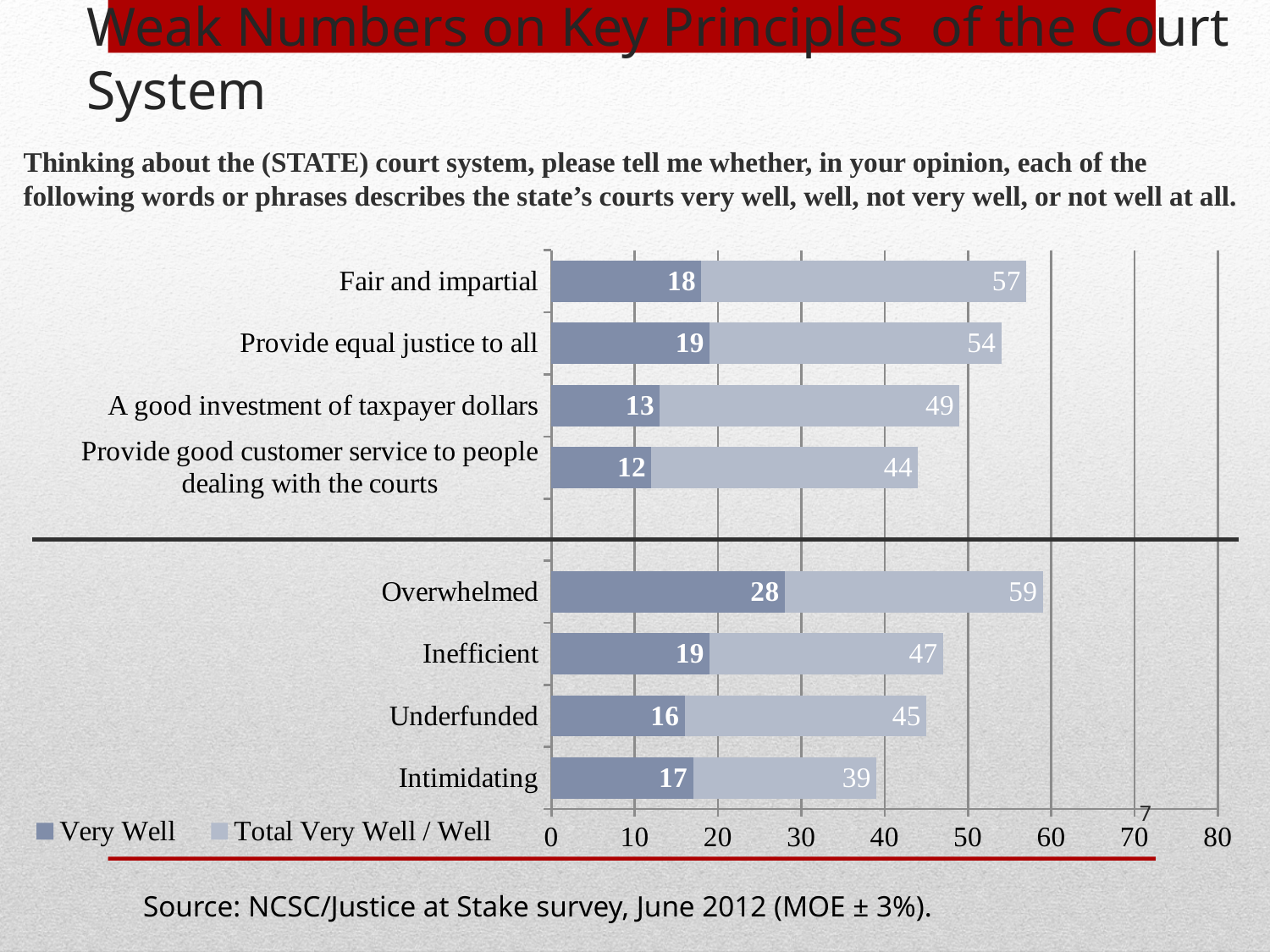
How many categories are shown in the chart? 8 What is the Total Very Well / Well value for Overwhelmed? 59 What is the difference between the Total Very Well / Well values for Fair and impartial and Provide equal justice to all? 3 Is the Total Very Well / Well value for A good investment of taxpayer dollars greater or less than 40? greater Which category has the highest Very Well value? Overwhelmed Which category has the lowest Total Very Well / Well value? Intimidating Which is larger, the Very Well value for Underfunded or the Very Well value for Intimidating? Intimidating What is the Total Very Well / Well value for Provide good customer service to people dealing with the courts? 44 How many series does the legend list? 2 What is the source cited below the chart? NCSC/Justice at Stake survey, June 2012 (MOE ± 3%) What is the Very Well value for Fair and impartial? 18 What kind of chart is shown on the slide? Bar chart